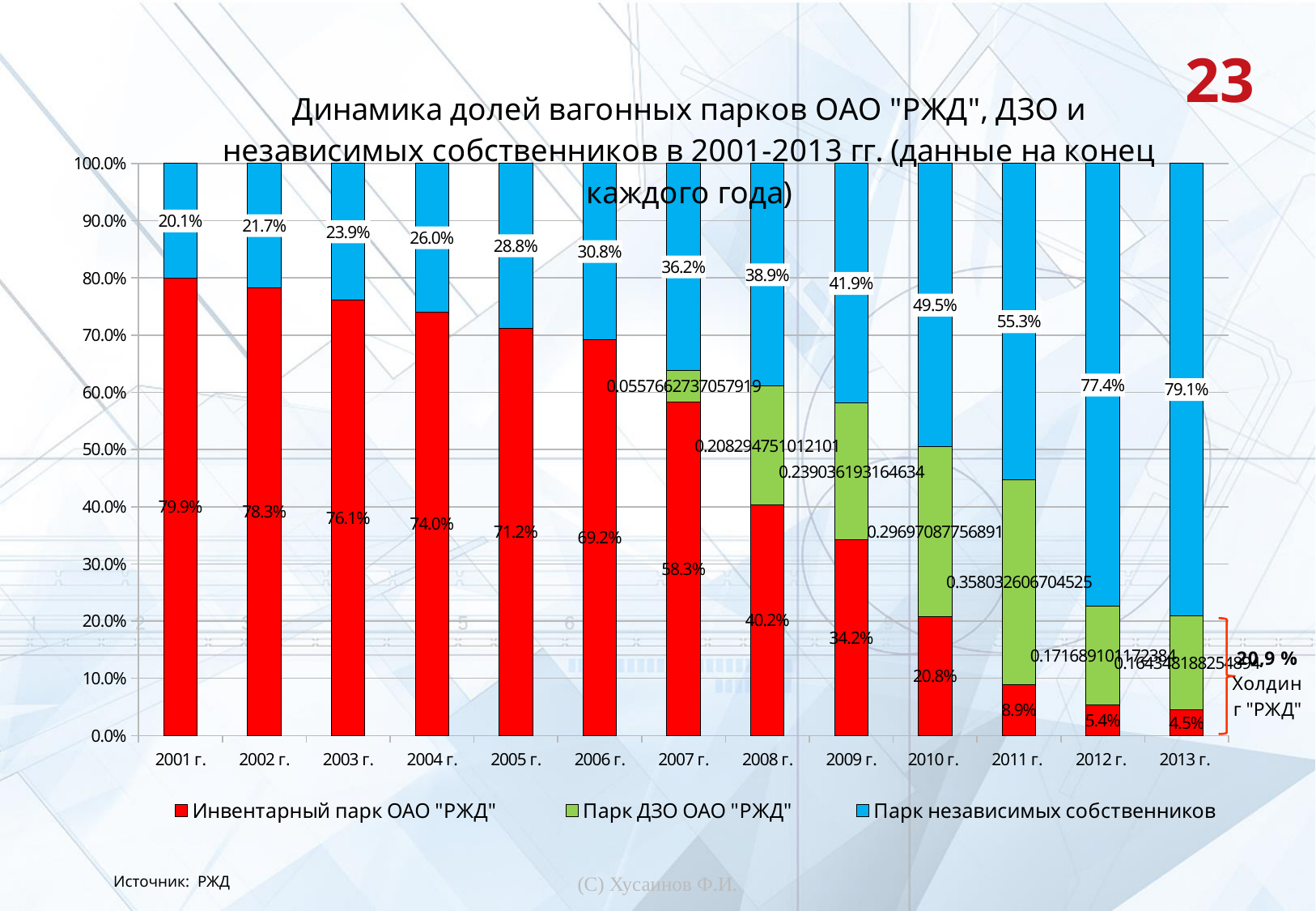
What is the share of Инвентарный парк ОАО "РЖД" in 2001 г.? 79.9% What is the share of Парк независимых собственников in 2007 г.? 36.2% How many years are shown on the x axis? 13 Does the share of Инвентарный парк ОАО "РЖД" rise or fall from 2001 г. to 2013 г.? fall Which is larger in 2009 г.: the share of Инвентарный парк ОАО "РЖД" or the share of Парк независимых собственников? Парк независимых собственников In which year is the share of Инвентарный парк ОАО "РЖД" the lowest? 2013 г. What kind of chart is shown on the slide? stacked bar chart How many series does the legend list? 3 In which year is the share of Парк независимых собственников the highest? 2013 г. What is the share of Парк независимых собственников in 2013 г.? 79.1% What is the difference between the share of Парк независимых собственников in 2012 г. and in 2011 г.? 22.1% What is the share of Инвентарный парк ОАО "РЖД" in 2010 г.? 20.8%